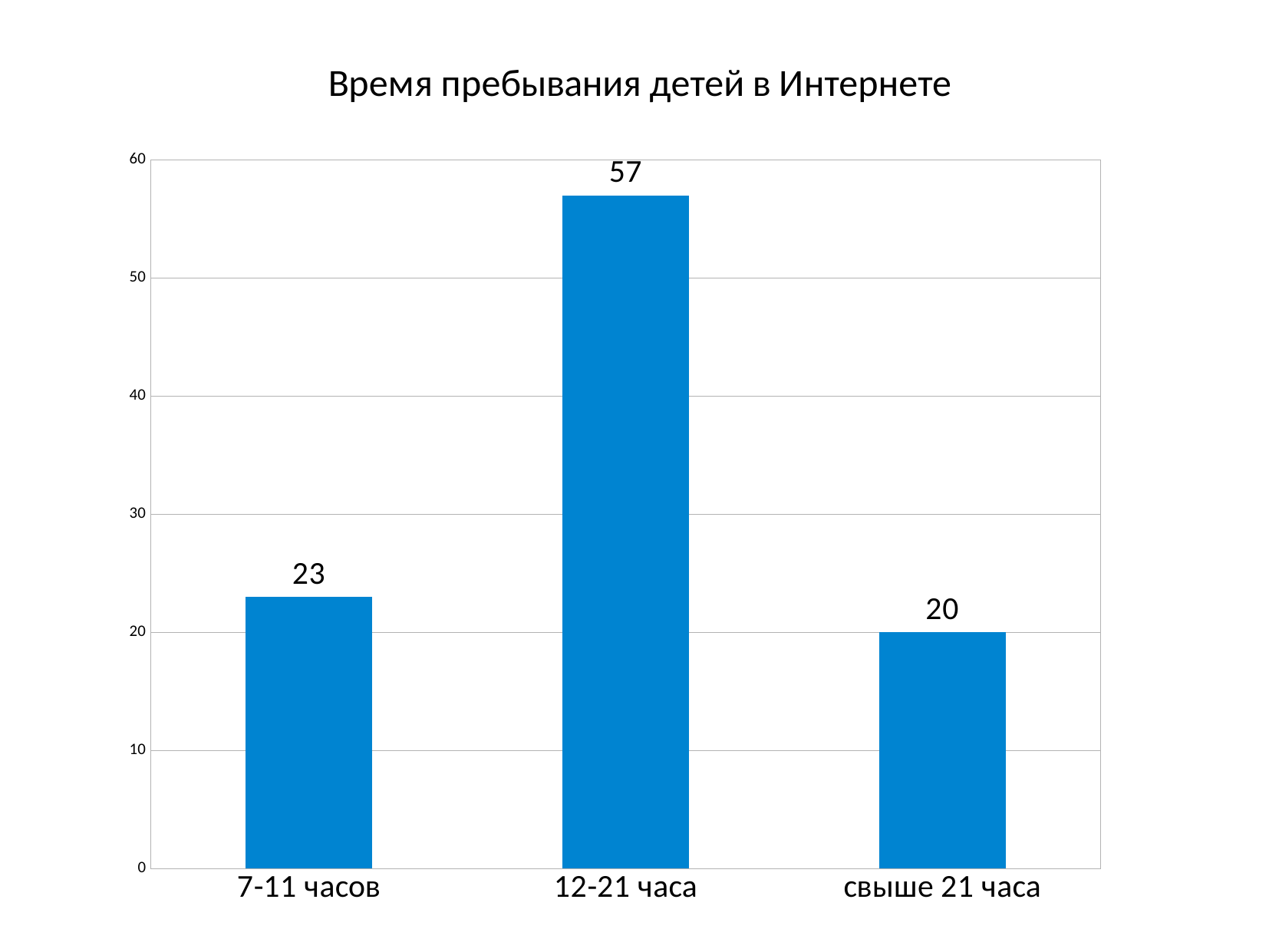
Is the value for "12-21 часа" greater or less than 50? greater What is the value for the category "свыше 21 часа"? 20 What is the value for the category "7-11 часов"? 23 What kind of chart is shown on the slide? bar chart Which is larger, the value for "7-11 часов" or the value for "свыше 21 часа"? 7-11 часов Which category has the lowest value? свыше 21 часа How many categories are shown on the x axis? 3 What is the title of the chart? Время пребывания детей в Интернете What is the value for the category "12-21 часа"? 57 What is the difference between the values for "7-11 часов" and "свыше 21 часа"? 3 What is the difference between the values for "12-21 часа" and "7-11 часов"? 34 Which category has the highest value? 12-21 часа